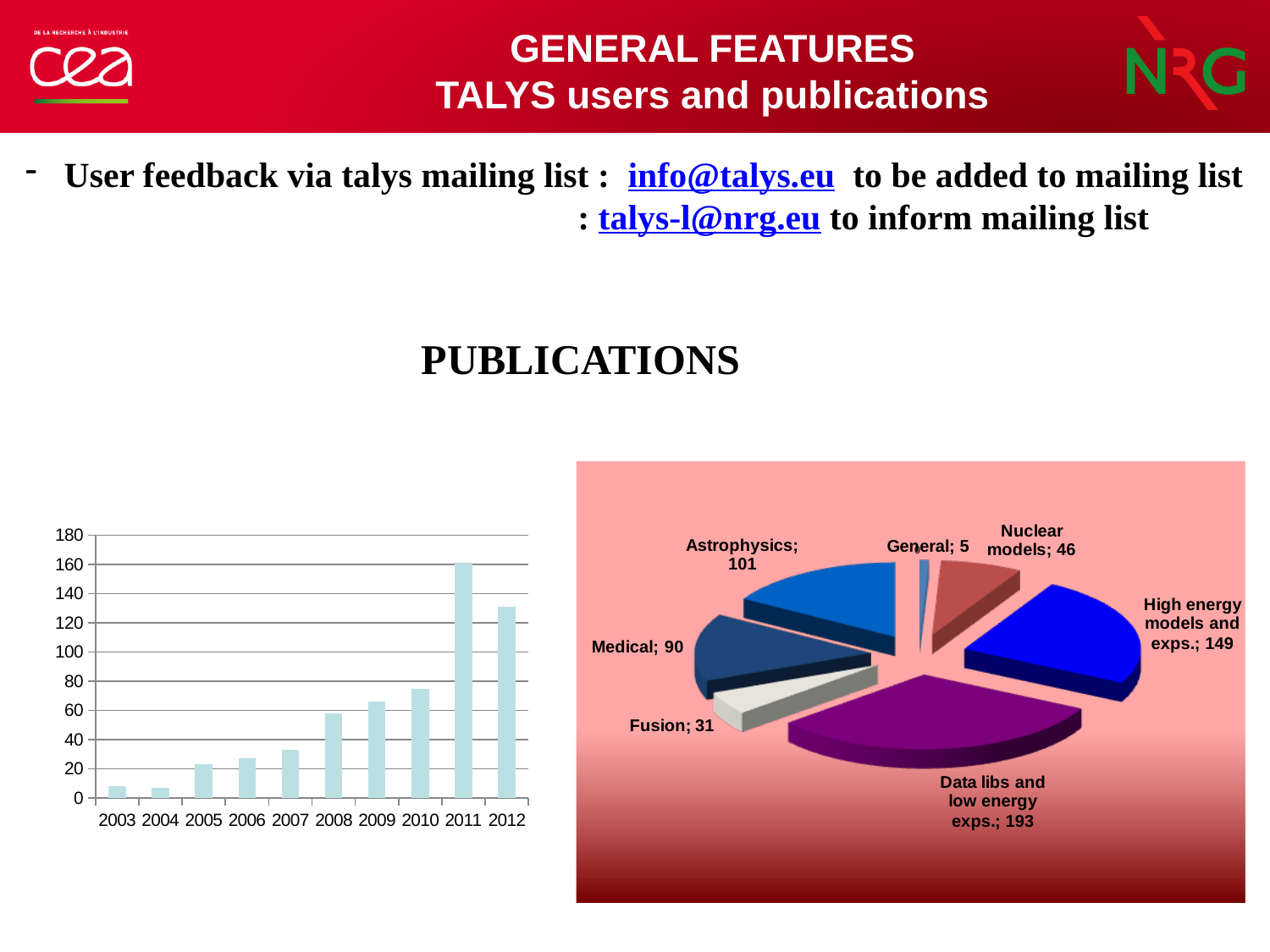
In the pie chart on the right, which category has the largest value? Data libs and low energy exps. In the pie chart on the right, what is the difference between 'Data libs and low energy exps.' and 'High energy models and exps.'? 44 In the pie chart on the right, which is larger: Medical or Nuclear models? Medical In the pie chart on the right, what is the value for Astrophysics? 101 How many categories does the pie chart on the right show? 7 In the pie chart on the right, which category has the smallest value? General In the pie chart on the right, how many publications are in the 'Data libs and low energy exps.' category? 193 In the bar chart on the left, is the value for 2011 greater or less than 140? greater In the pie chart on the right, what is the value for Fusion? 31 In the bar chart on the left, is the value for 2003 greater or less than 20? less In the bar chart on the left, which year has the highest value? 2011 What kind of chart is shown on the left of the slide? Bar chart